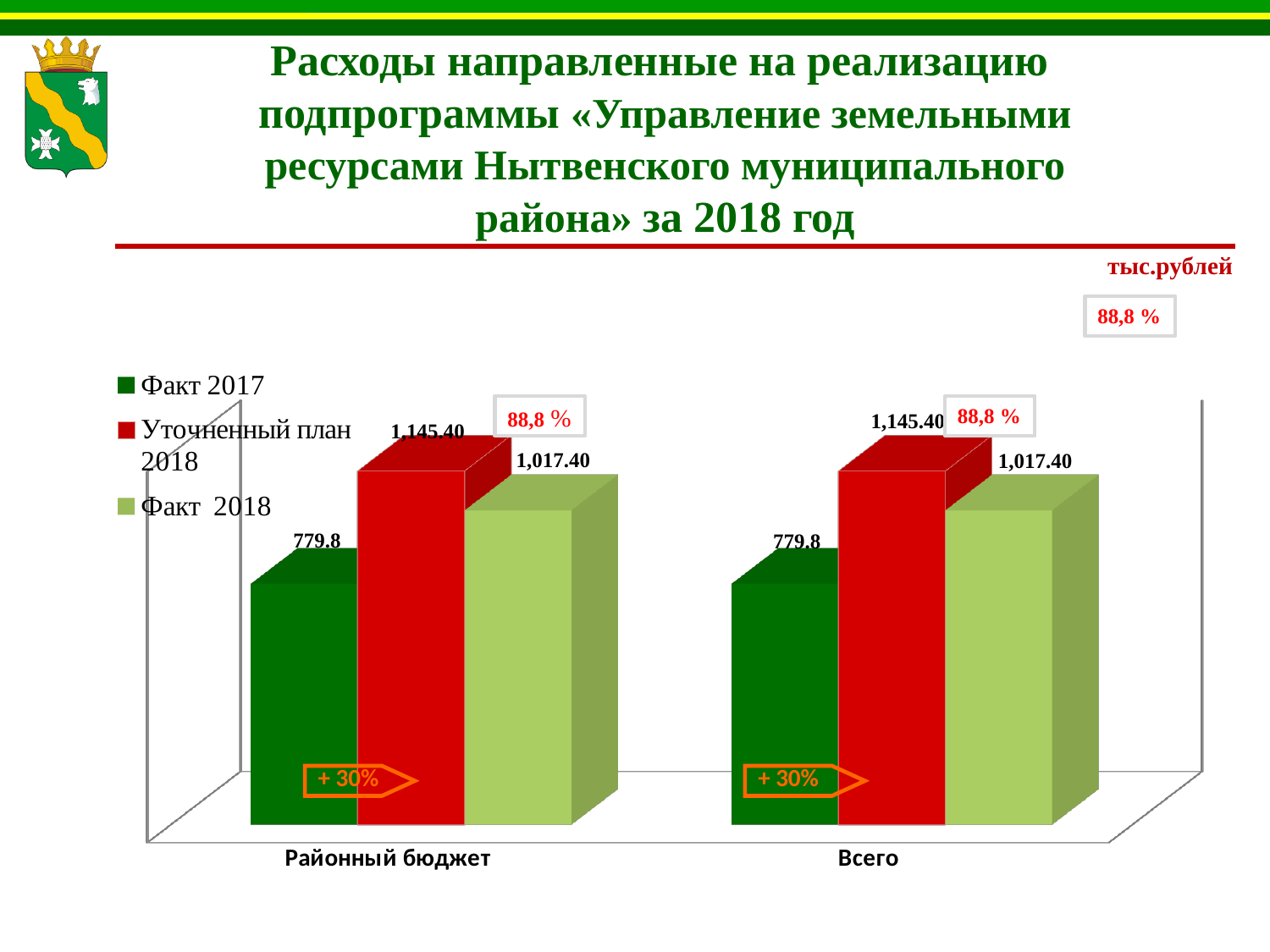
What is the value of Факт 2017 for Районный бюджет? 779.8 What is the difference between Уточненный план 2018 and Факт 2018 for Всего? 128.00 What is the value of Уточненный план 2018 for Всего? 1,145.40 What unit of measurement is indicated for the chart values? тыс.рублей What colour are the bars for the Факт 2017 series? dark green Which series has the lowest value for Районный бюджет? Факт 2017 Which is larger for Районный бюджет: Факт 2017 or Факт 2018? Факт 2018 How many series does the legend list? 3 What type of chart is shown on the slide? bar chart What is the value of Факт 2018 for Районный бюджет? 1,017.40 How many categories are shown on the x axis? 2 Which series has the highest value for Всего? Уточненный план 2018